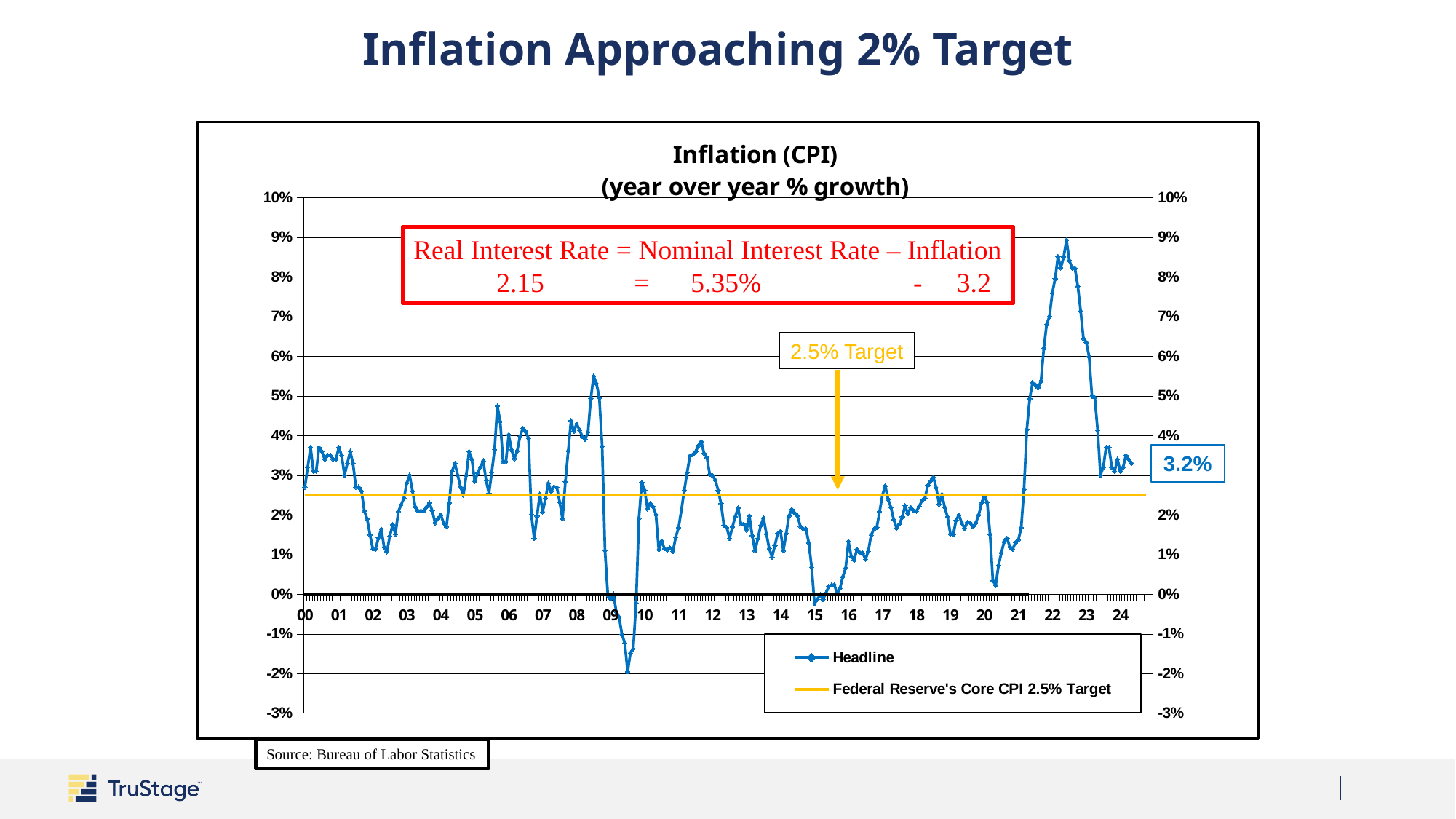
In which year does Headline inflation reach its highest point on the chart? 22 At what level is the Federal Reserve's Core CPI target line drawn? 2.5% What is the most recent Headline inflation value labeled on the chart? 3.2% Is the lowest Headline inflation value in 2009 greater or less than -1%? less What is the title of the chart? Inflation (CPI) (year over year % growth) Which peak is higher: Headline inflation in 2022 or in 2008? 2022 In which year does Headline inflation reach its lowest point on the chart? 09 Does Headline inflation rise or fall from 2022 to 2024? fall How many series does the chart's legend list? 2 Is the Headline inflation value in 2015 greater or less than 1%? less What kind of chart is shown on the slide? line chart Is the peak Headline inflation value in 2022 greater or less than 8%? greater